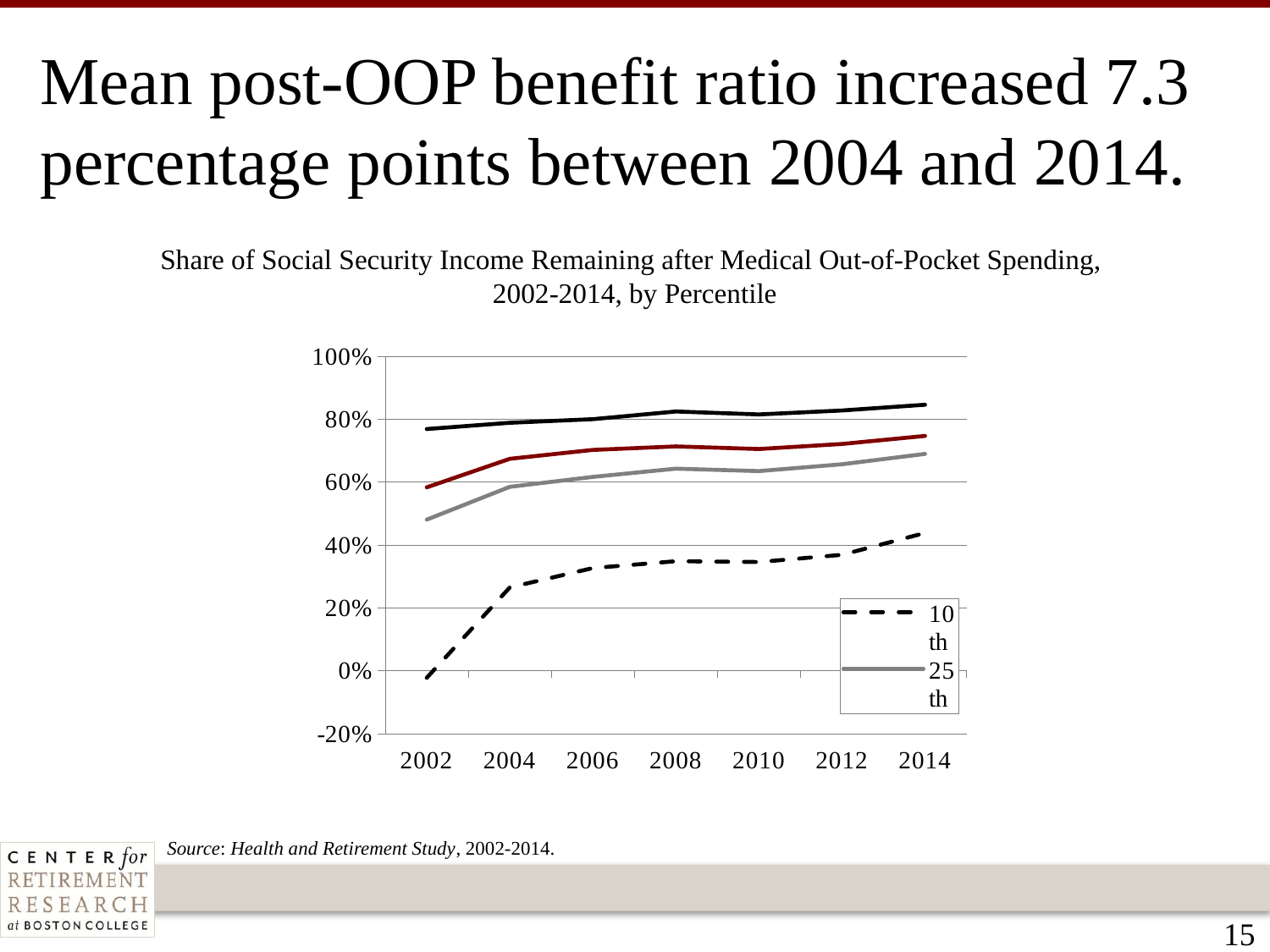
In which year is the 10th percentile line at its lowest? 2002 Is the value for the 25th percentile in 2002 greater or less than 60%? less Does the 10th percentile line rise or fall between 2002 and 2014? rise Is the value for the 10th percentile in 2014 greater or less than 40%? greater Which is larger in 2014, the value for the 25th percentile or the 10th percentile? 25th percentile In which year is the 10th percentile line at its highest? 2014 What is the title of the chart? Share of Social Security Income Remaining after Medical Out-of-Pocket Spending, 2002-2014, by Percentile What kind of chart is shown on the slide? line chart Is the value for the 10th percentile in 2008 greater or less than 40%? less Which line style is used for the 10th percentile series in the legend? dashed How many years are labeled along the x axis of the chart? 7